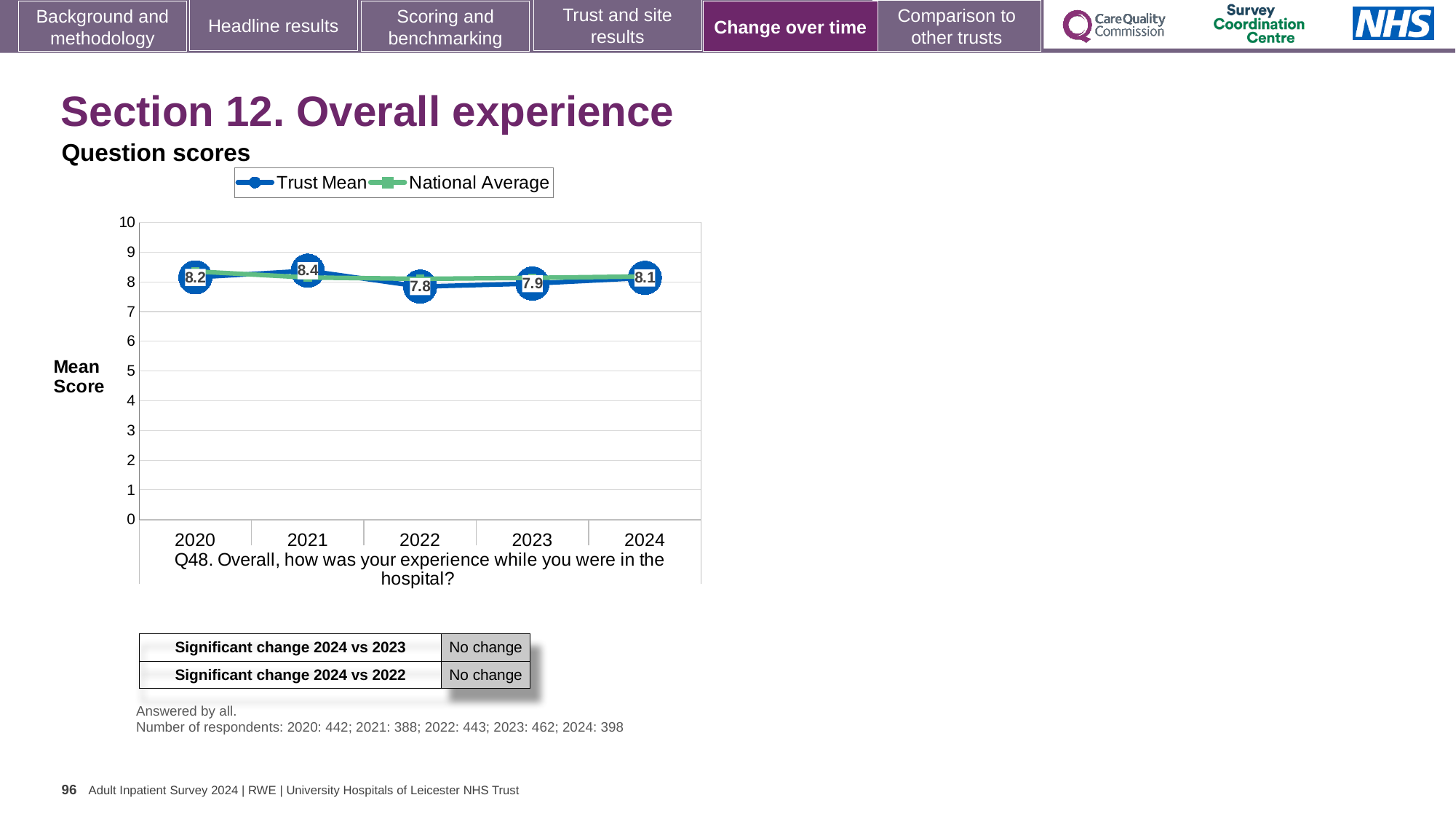
Is the National Average value for 2022 greater or less than 7? greater How many series does the legend list? 2 What is the difference between the Trust Mean scores for 2021 and 2022? 0.6 Does the Trust Mean score rise or fall from 2021 to 2022? Fall What kind of chart is shown? Line chart What is the Trust Mean score for 2022? 7.8 Which year has the larger Trust Mean score, 2020 or 2023? 2020 What is the Trust Mean score for 2021? 8.4 What is the Trust Mean score for 2024? 8.1 In which year is the Trust Mean score highest? 2021 In which year is the Trust Mean score lowest? 2022 How many years are plotted on the x axis? 5